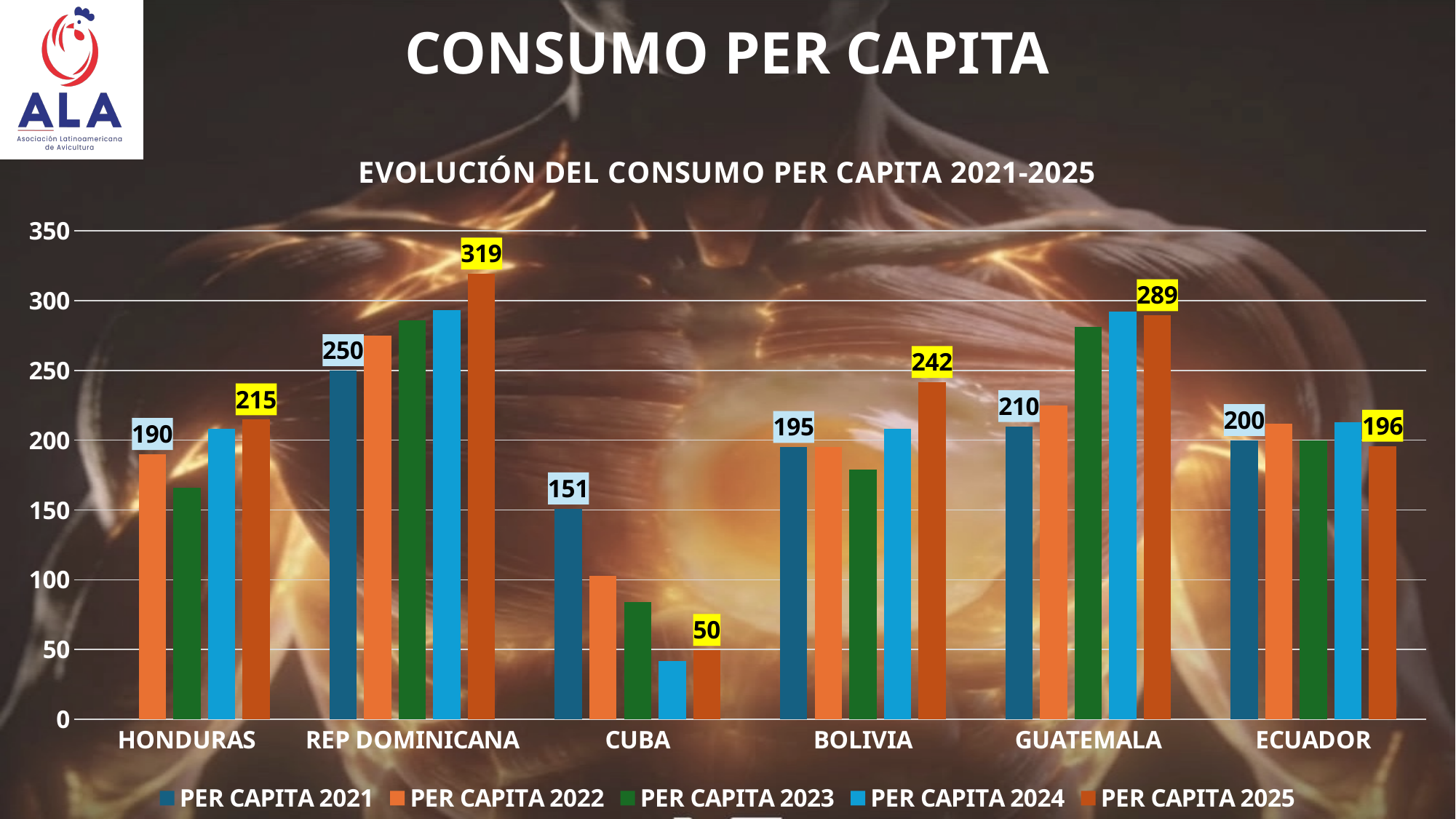
How many countries are shown on the x axis? 6 Is the PER CAPITA 2024 value for CUBA greater or less than 50? less For ECUADOR, which is larger: the PER CAPITA 2021 value or the PER CAPITA 2025 value? PER CAPITA 2021 What kind of chart is shown on the slide? bar chart What is the difference between the PER CAPITA 2025 and PER CAPITA 2021 values for BOLIVIA? 47 Which country has the lowest PER CAPITA 2025 value? CUBA Do the values for REP DOMINICANA rise or fall from PER CAPITA 2021 to PER CAPITA 2025? rise What is the PER CAPITA 2025 value for CUBA? 50 What is the PER CAPITA 2021 value for GUATEMALA? 210 What is the PER CAPITA 2025 value for REP DOMINICANA? 319 How many series does the legend list? 5 Which country has the highest PER CAPITA 2025 value? REP DOMINICANA